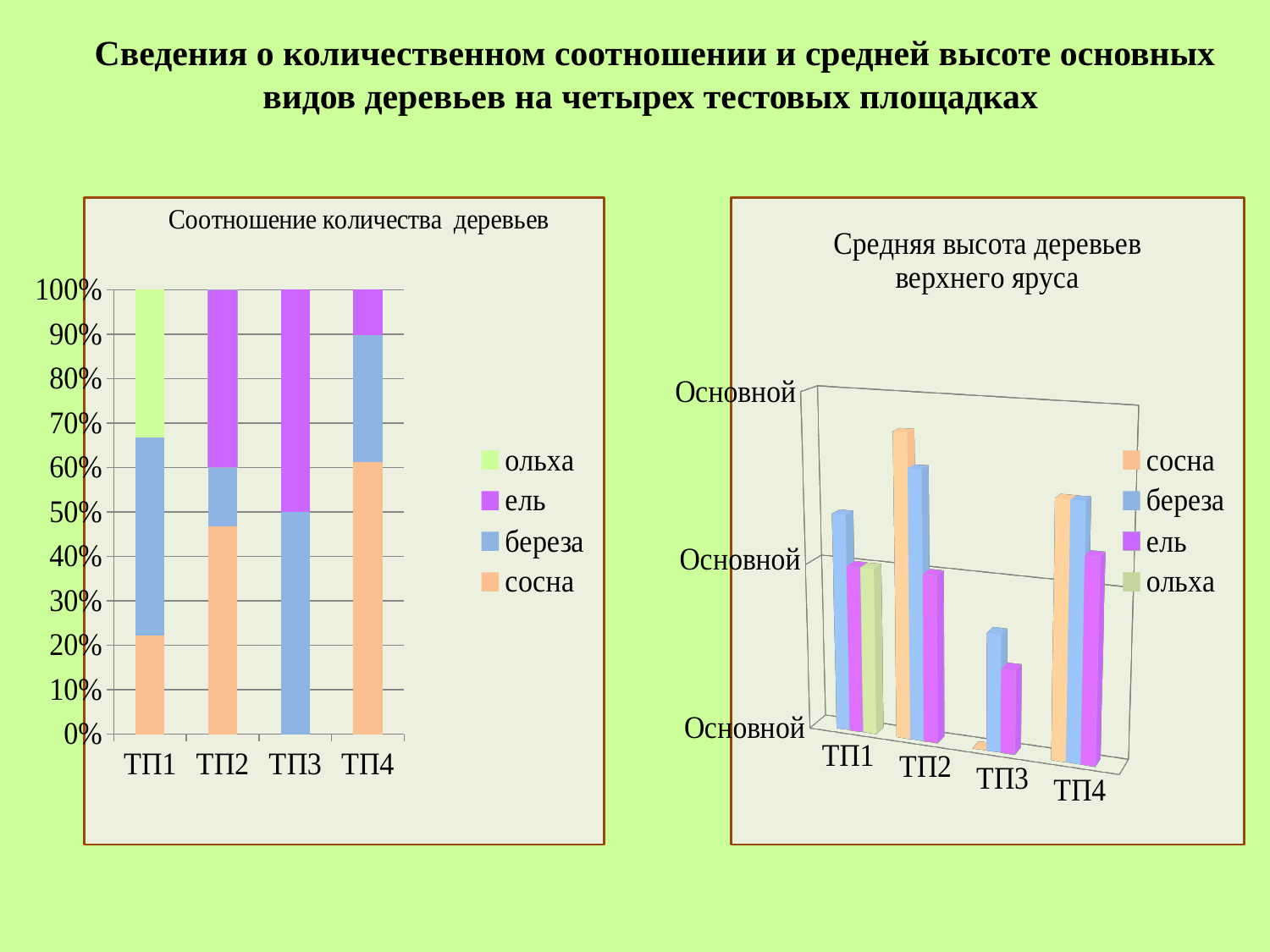
On the left chart (Соотношение количества деревьев), which test plot has the largest share of сосна? ТП4 What kind of chart is the left chart (Соотношение количества деревьев)? Stacked bar chart On the left chart (Соотношение количества деревьев), which test plot is the only one with an ольха segment? ТП1 On the left chart (Соотношение количества деревьев), is the share of сосна for ТП4 greater or less than 50%? greater On the left chart (Соотношение количества деревьев), is the share of сосна for ТП2 greater or less than 50%? less On the left chart (Соотношение количества деревьев), is the share of ольха for ТП1 greater or less than 40%? less On the right chart (Средняя высота деревьев верхнего яруса), for ТП3, which is taller: береза or ель? береза On the left chart (Соотношение количества деревьев), how many series does the legend list? 4 What is the title of the right chart? Средняя высота деревьев верхнего яруса On the right chart (Средняя высота деревьев верхнего яруса), which series has the tallest bar for ТП2? сосна On the right chart (Средняя высота деревьев верхнего яруса), which test plot has the tallest сосна bar? ТП2 On the left chart (Соотношение количества деревьев), how many test plots are shown on the x axis? 4